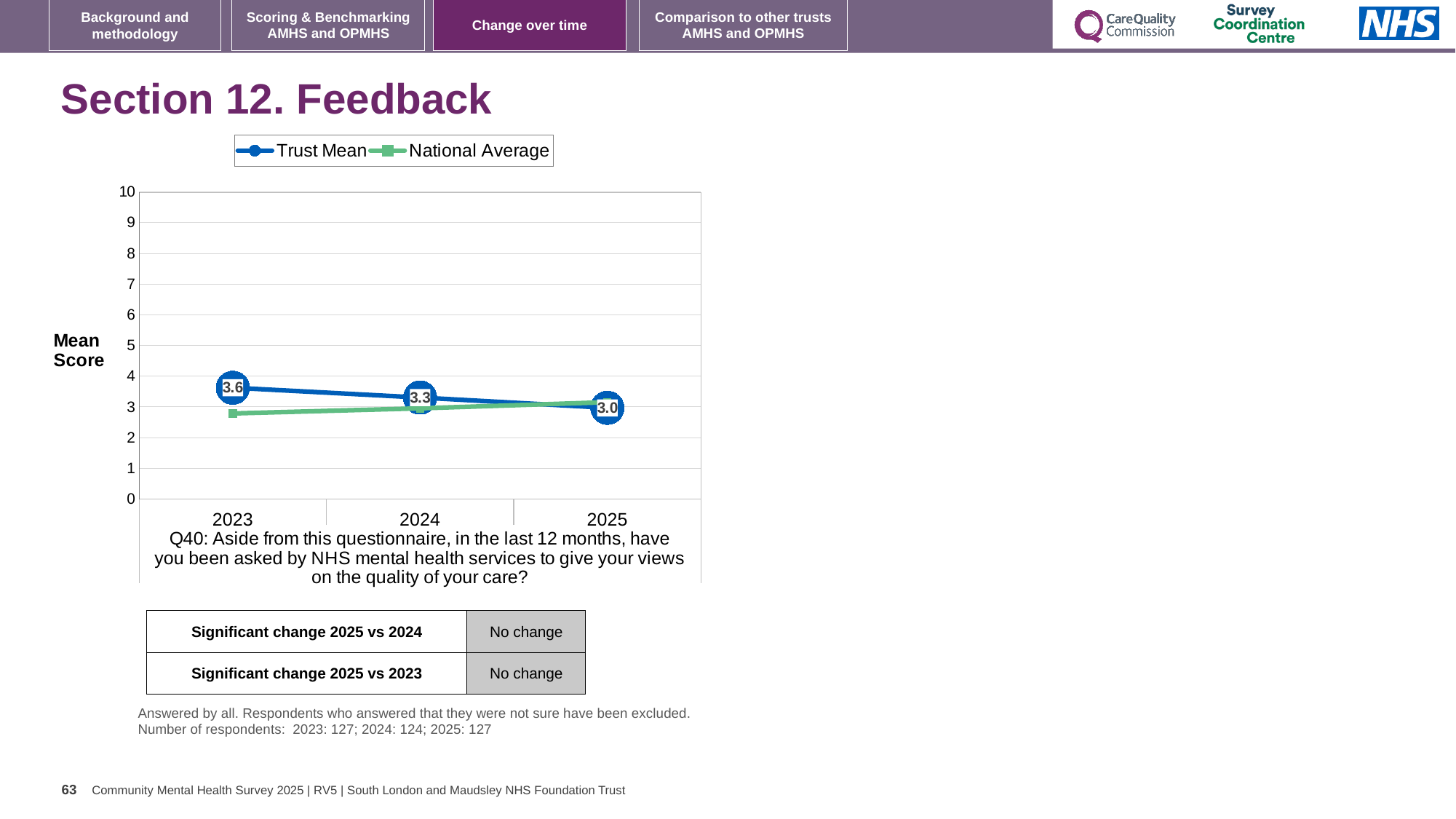
Does the Trust Mean rise or fall from 2023 to 2025? fall What is the Trust Mean score for 2023? 3.6 How many series does the legend list? 2 What is the difference between the Trust Mean in 2023 and in 2025? 0.6 Is the National Average value for 2023 greater or less than 3? less In which year is the Trust Mean lowest? 2025 What is the Trust Mean score for 2025? 3.0 What is the Trust Mean score for 2024? 3.3 How many years are plotted on the x axis? 3 In which year is the Trust Mean highest? 2023 In 2023, which is larger: the Trust Mean or the National Average? Trust Mean What kind of chart is shown on the slide? line chart